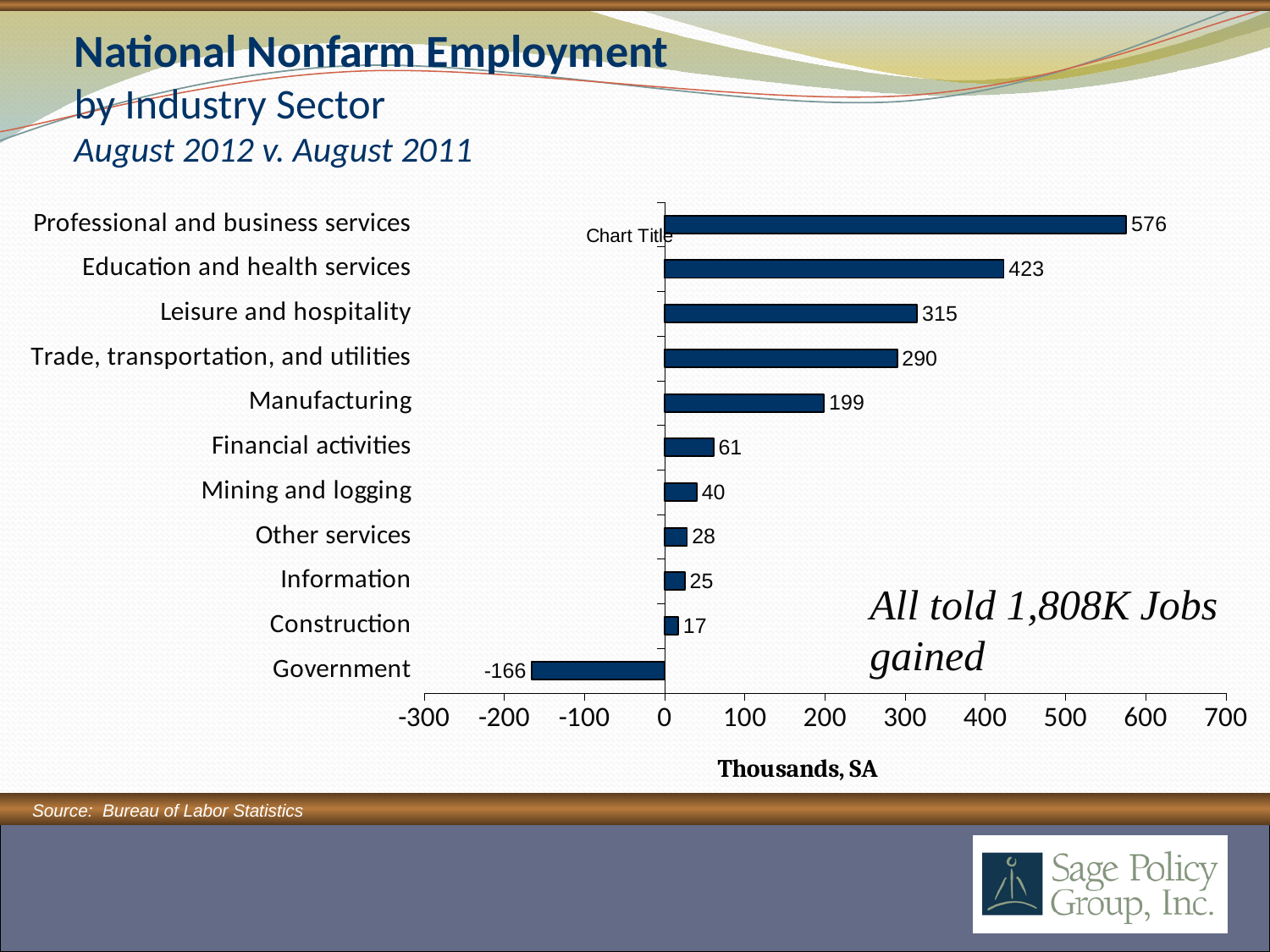
What is the value for Professional and business services? 576 What is the value for Government? -166 Which industry sector has the highest value? Professional and business services How many industry sectors are shown in the chart? 11 What kind of chart is shown on the slide? Bar chart Which is larger, Trade, transportation, and utilities or Manufacturing? Trade, transportation, and utilities What unit label is shown below the x axis? Thousands, SA What is the value for Mining and logging? 40 Which industry sector has the lowest value? Government What is the value for Manufacturing? 199 What is the difference between Education and health services and Leisure and hospitality? 108 Is the value for Financial activities greater or less than 100? less